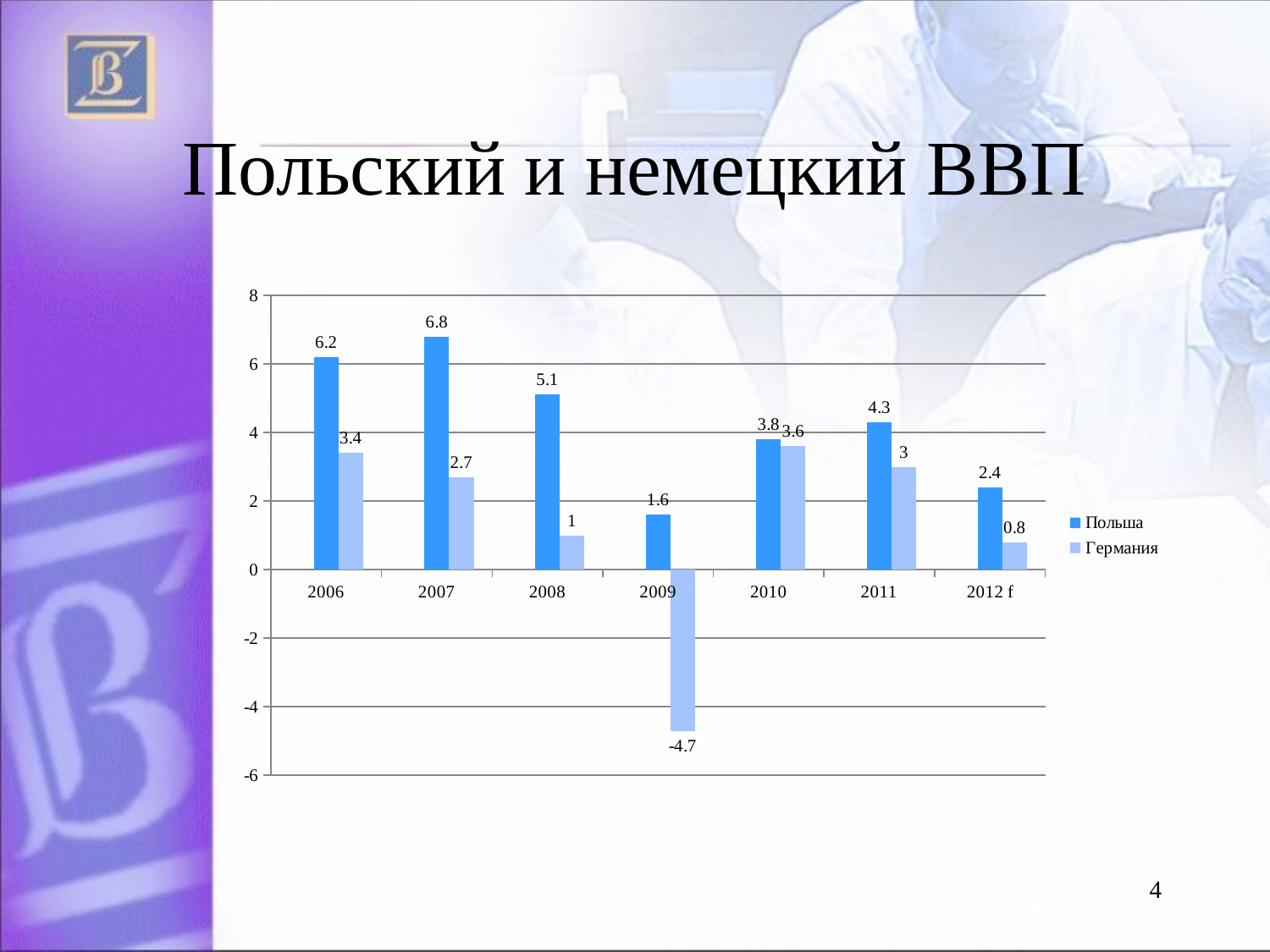
What is the title of the slide? Польский и немецкий ВВП In which year is the Польша value highest? 2007 Does the Польша value rise or fall from 2006 to 2009? Fall What is the difference between the Польша and Германия values in 2008? 4.1 What is the value for Польша in 2007? 6.8 In which year is the Германия value lowest? 2009 How many years are shown on the x axis? 7 What is the value for Германия in 2009? -4.7 How many series does the legend list? 2 Which is larger in 2010, the Польша value or the Германия value? Польша What kind of chart is shown on the slide? Bar chart What is the value for Германия in 2012 f? 0.8